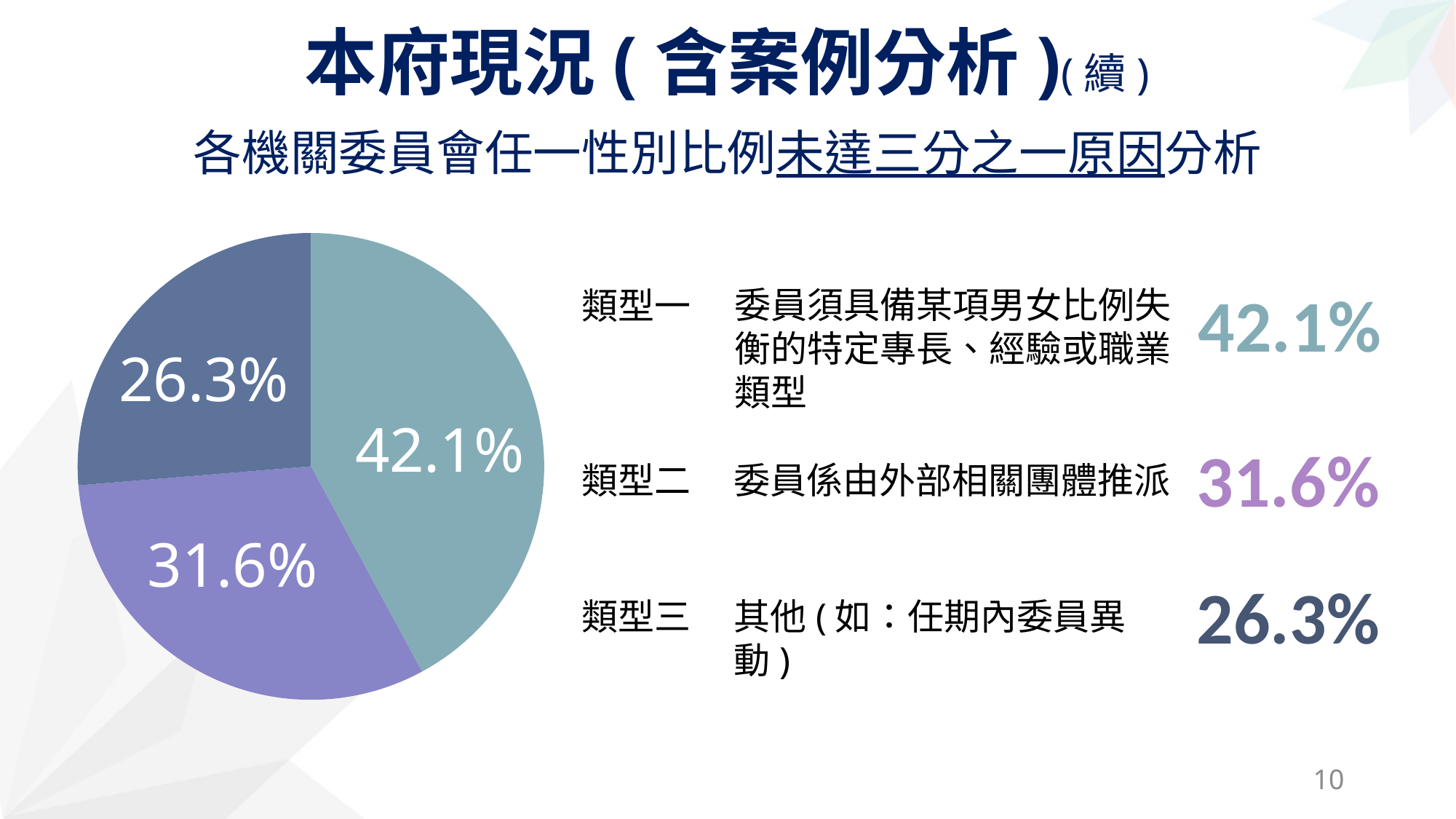
What is the difference in percentage points between 類型一 and 類型三? 15.8 How many slices does the pie chart have? 3 What percentage does the pie chart show for 類型二 (委員係由外部相關團體推派)? 31.6% What percentage does the pie chart show for 類型一 (委員須具備某項男女比例失衡的特定專長、經驗或職業類型)? 42.1% Which category has the largest share of the pie chart? 類型一 What percentage does the pie chart show for 類型三 (其他)? 26.3% What is the difference in percentage points between 類型二 and 類型三? 5.3 What colour is the slice representing 類型二 in the pie chart? purple Which is larger, the share for 類型二 or the share for 類型三? 類型二 What kind of chart is shown on the slide? pie chart Which category has the smallest share of the pie chart? 類型三 What is the share of the pie taken by the teal slice? 42.1%